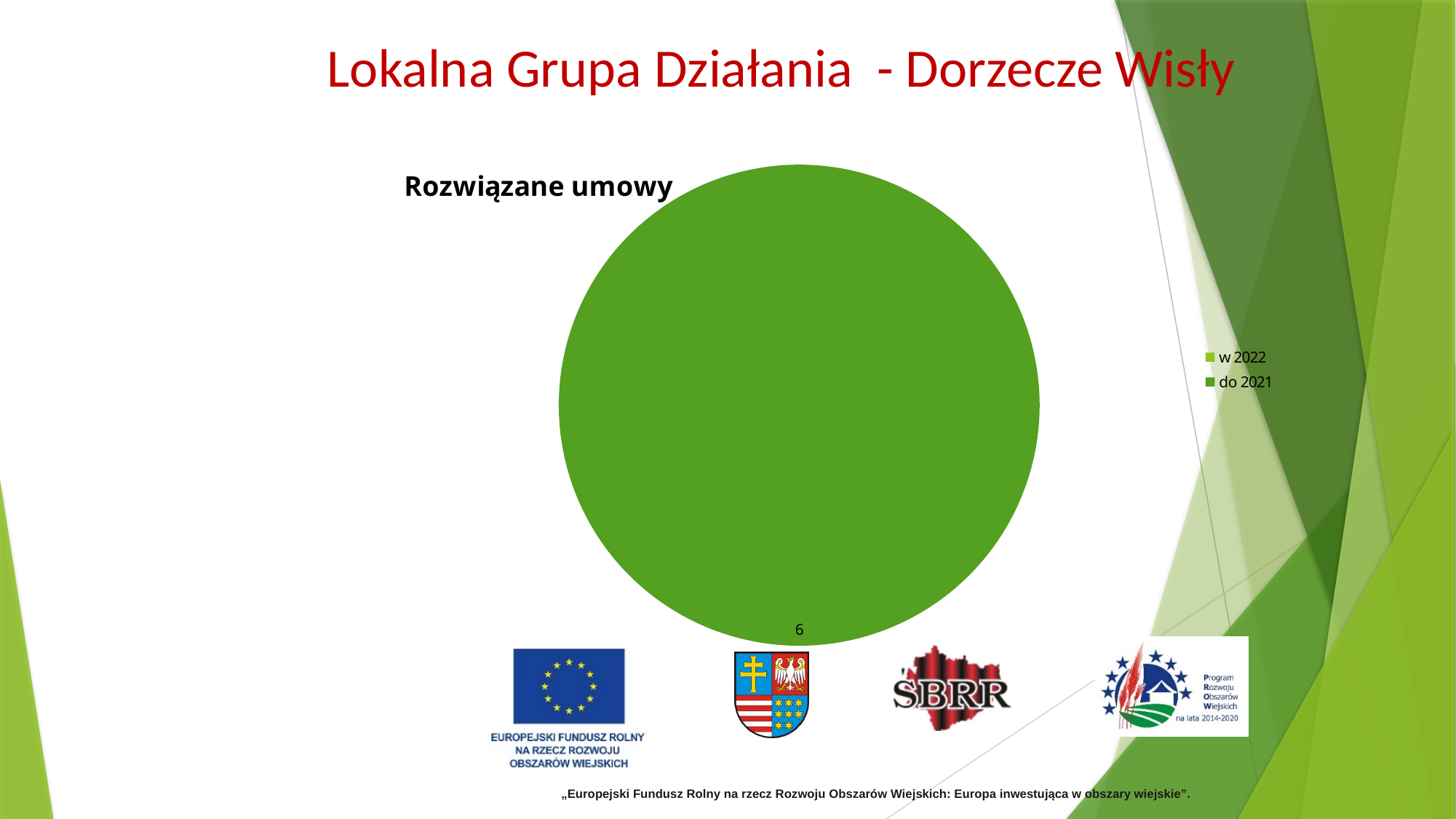
Which legend category does the visible pie slice belong to? do 2021 What are the two legend entries of the chart? w 2022 and do 2021 What kind of chart is shown on the slide? pie chart Which category has the larger share of the pie, w 2022 or do 2021? do 2021 What is the title of the chart? Rozwiązane umowy What is the value shown for do 2021 in the pie chart? 6 How many entries does the chart legend list? 2 What value is printed as a data label on the pie chart? 6 Is the value labelled on the pie chart greater or less than 10? less